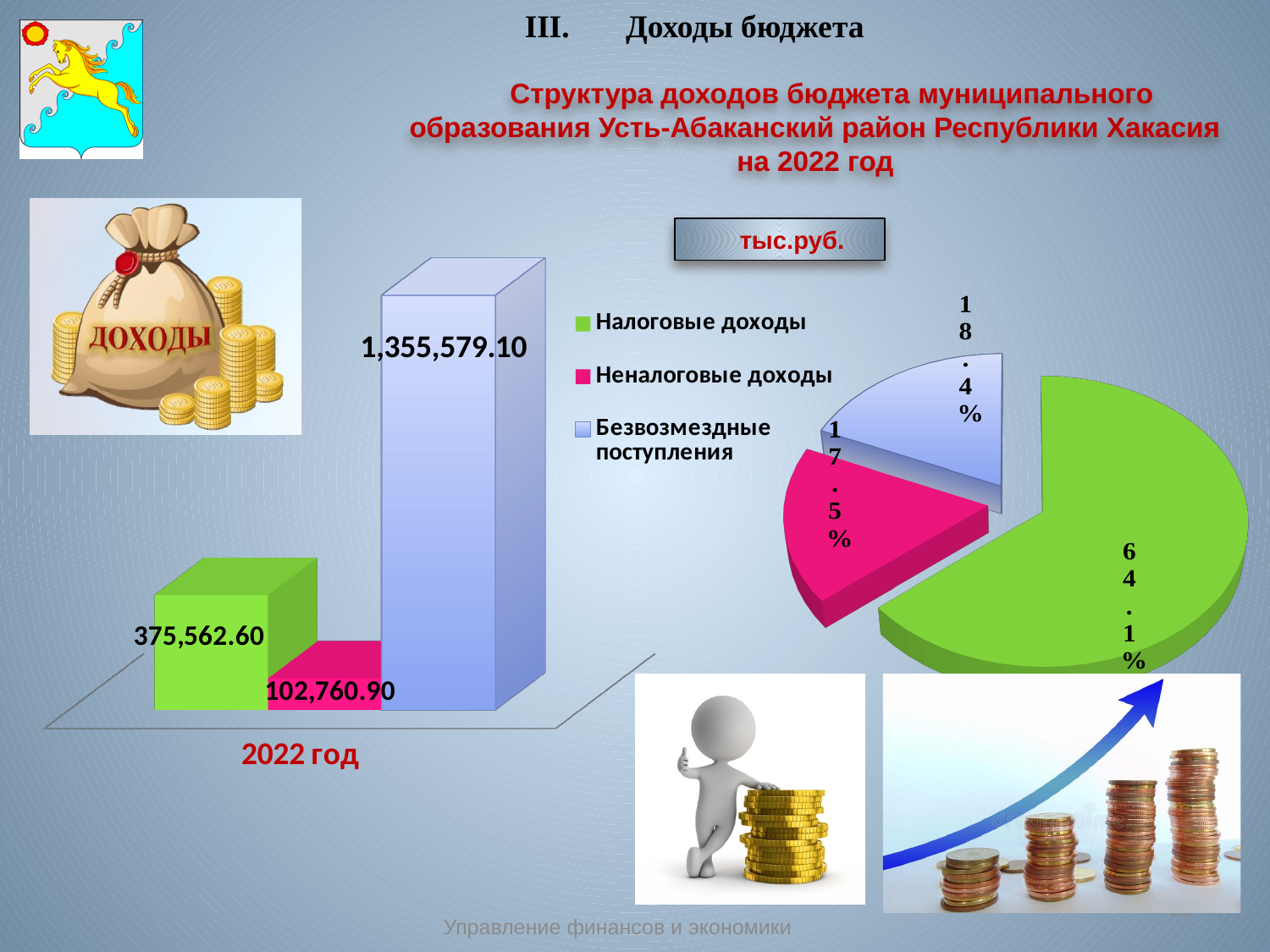
On the bar chart, which category has the highest value? Безвозмездные поступления What kind of chart is the chart on the right of the slide? Pie chart How many series does the legend list? 3 On the bar chart, what is the value for Налоговые доходы in 2022 год? 375,562.60 On the bar chart, which category has the lowest value? Неналоговые доходы On the bar chart, what is the difference between Налоговые доходы and Неналоговые доходы? 272,801.70 What kind of chart is the chart on the left of the slide? Bar chart On the pie chart, what share is shown for the pink slice? 17.5% On the bar chart, what is the value for Безвозмездные поступления in 2022 год? 1,355,579.10 On the bar chart, which is larger: Налоговые доходы or Безвозмездные поступления? Безвозмездные поступления On the pie chart, what share is shown for the largest (green) slice? 64.1% On the bar chart, what is the value for Неналоговые доходы in 2022 год? 102,760.90